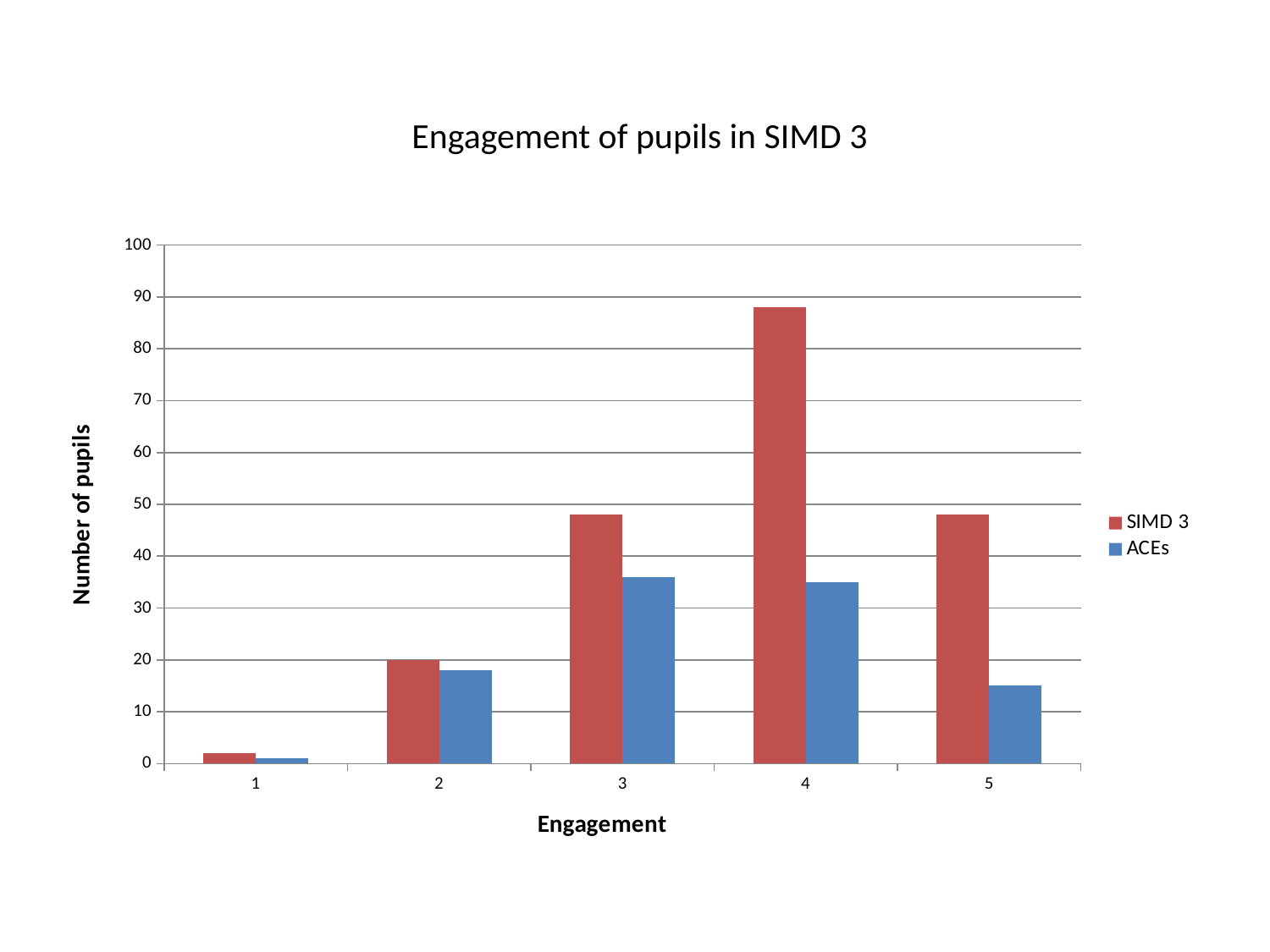
Which series is shown in blue? ACEs Is the value for SIMD 3 at engagement level 4 greater or less than 80? greater Is the value for ACEs at engagement level 3 greater or less than 30? greater How many series does the legend list? 2 Is the value for ACEs at engagement level 5 greater or less than 20? less Which engagement level has the highest value for SIMD 3? 4 How many engagement categories are shown on the x axis? 5 Which engagement level has the lowest value for SIMD 3? 1 What is the title of the chart? Engagement of pupils in SIMD 3 What kind of chart is shown on the slide? bar chart Which engagement level has the lowest value for ACEs? 1 At engagement level 5, which series has the larger value, SIMD 3 or ACEs? SIMD 3